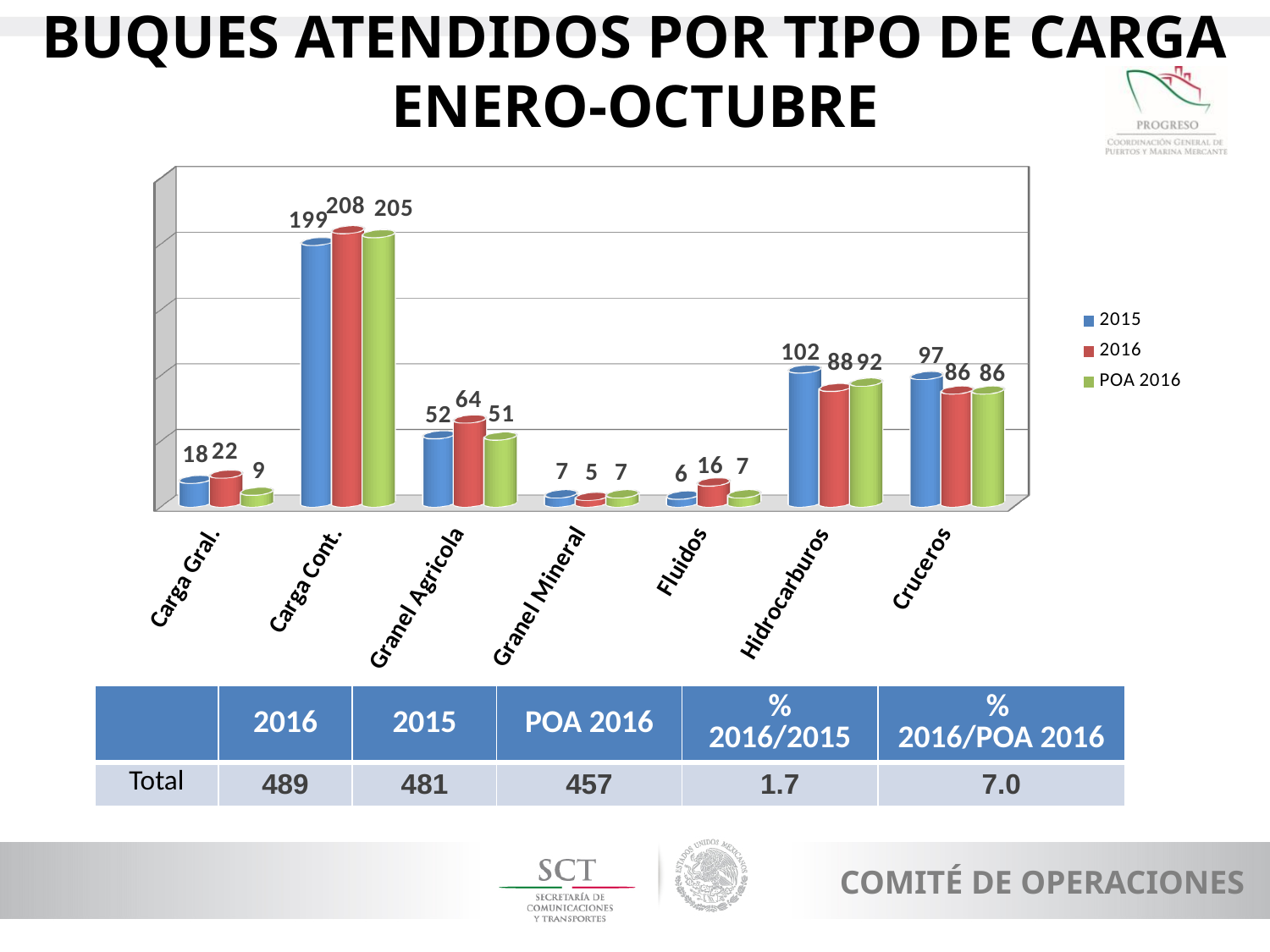
What kind of chart is shown on the slide? Bar chart What is the 2016 value for Carga Cont.? 208 Which category has the lowest 2015 value? Fluidos What is the difference between the 2016 and 2015 values for Fluidos? 10 What is the POA 2016 value for Carga Gral.? 9 What is the difference between the 2015 and 2016 values for Hidrocarburos? 14 Which category has the highest 2016 value? Carga Cont. What is the 2015 value for Hidrocarburos? 102 How many cargo categories are shown on the x axis? 7 How many series does the legend list? 3 Which colour represents the POA 2016 series? Green Which is larger for Granel Agricola, the 2016 value or the POA 2016 value? 2016